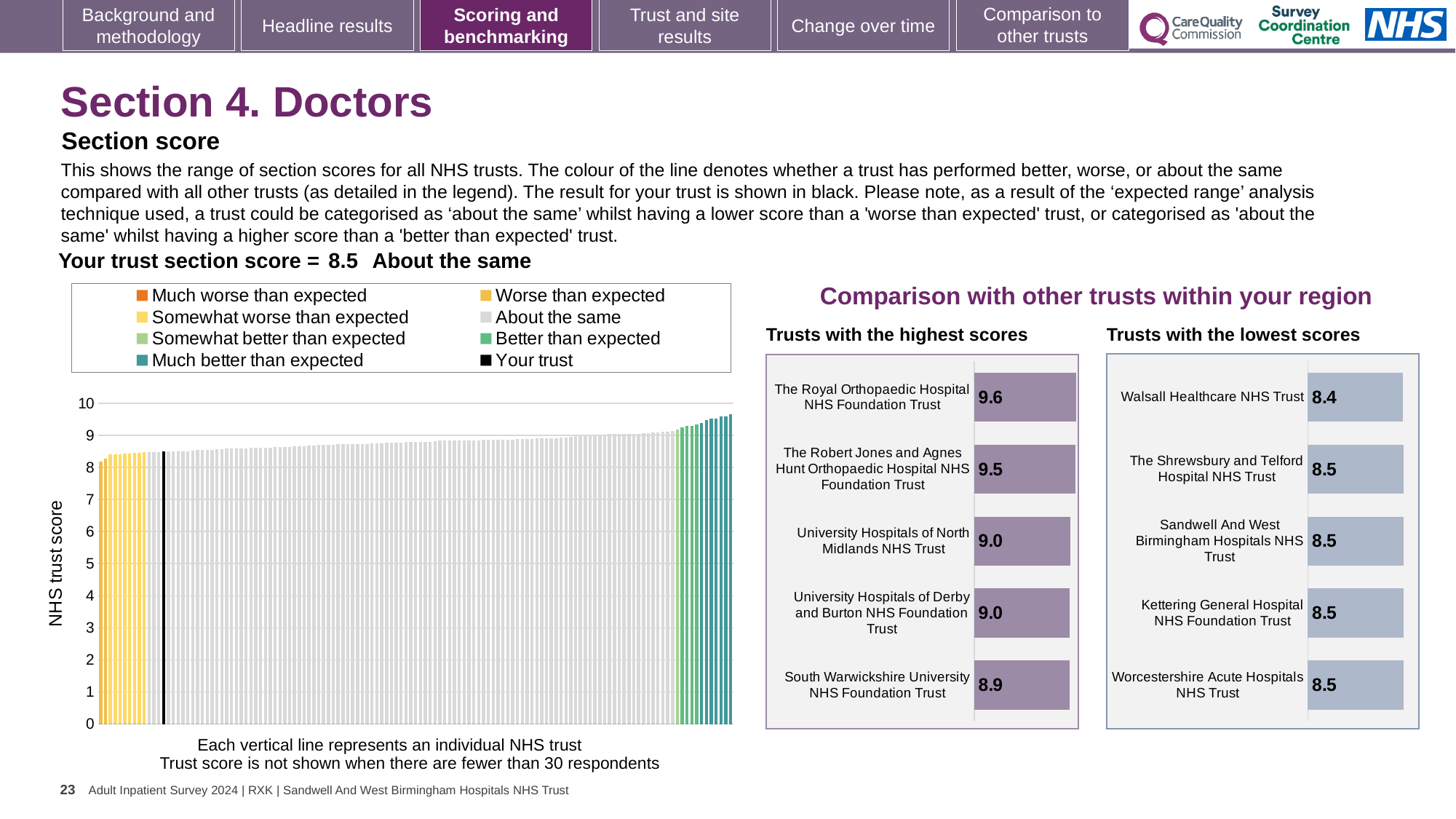
How many entries does the legend of the main chart on the left list? 8 In the 'Trusts with the lowest scores' chart, which is larger: the score for Walsall Healthcare NHS Trust or Kettering General Hospital NHS Foundation Trust? Kettering General Hospital NHS Foundation Trust In the 'Trusts with the lowest scores' chart, what is the score for Sandwell And West Birmingham Hospitals NHS Trust? 8.5 In the 'Trusts with the highest scores' chart, what is the score for The Royal Orthopaedic Hospital NHS Foundation Trust? 9.6 In the 'Trusts with the highest scores' chart, how many trusts are shown? 5 In the 'Trusts with the highest scores' chart, what is the difference between the scores of The Royal Orthopaedic Hospital NHS Foundation Trust and South Warwickshire University NHS Foundation Trust? 0.7 In the 'Trusts with the lowest scores' chart, what is the score for Walsall Healthcare NHS Trust? 8.4 In the 'Trusts with the highest scores' chart, which trust has the highest score? The Royal Orthopaedic Hospital NHS Foundation Trust In the 'Trusts with the lowest scores' chart, which trust has the lowest score? Walsall Healthcare NHS Trust In the 'Trusts with the highest scores' chart, what is the score for South Warwickshire University NHS Foundation Trust? 8.9 In the main chart of NHS trust scores on the left, what is the section score for your trust? 8.5 In the main chart of NHS trust scores on the left, do the values rise or fall from left to right? rise